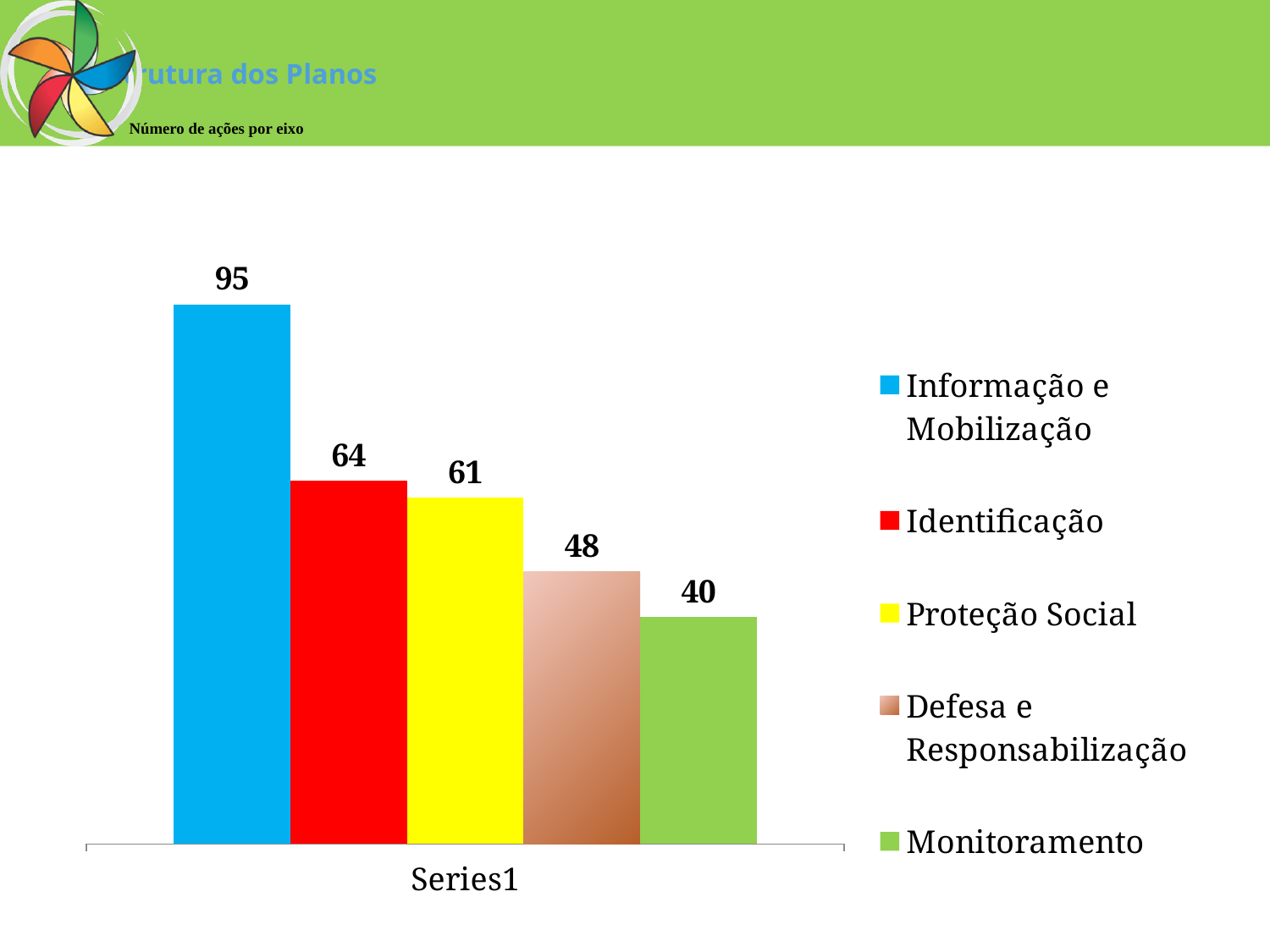
What is the value for Identificação? 64 What kind of chart is shown on the slide? Bar chart Which category has the highest value? Informação e Mobilização Which category has the lowest value? Monitoramento What is the difference between the values for Identificação and Proteção Social? 3 How many categories does the legend list? 5 What is the difference between the values for Informação e Mobilização and Monitoramento? 55 What is the value for Monitoramento? 40 What is the value for Informação e Mobilização? 95 What is the value for Defesa e Responsabilização? 48 Which is larger, the value for Defesa e Responsabilização or the value for Monitoramento? Defesa e Responsabilização What is the value for Proteção Social? 61